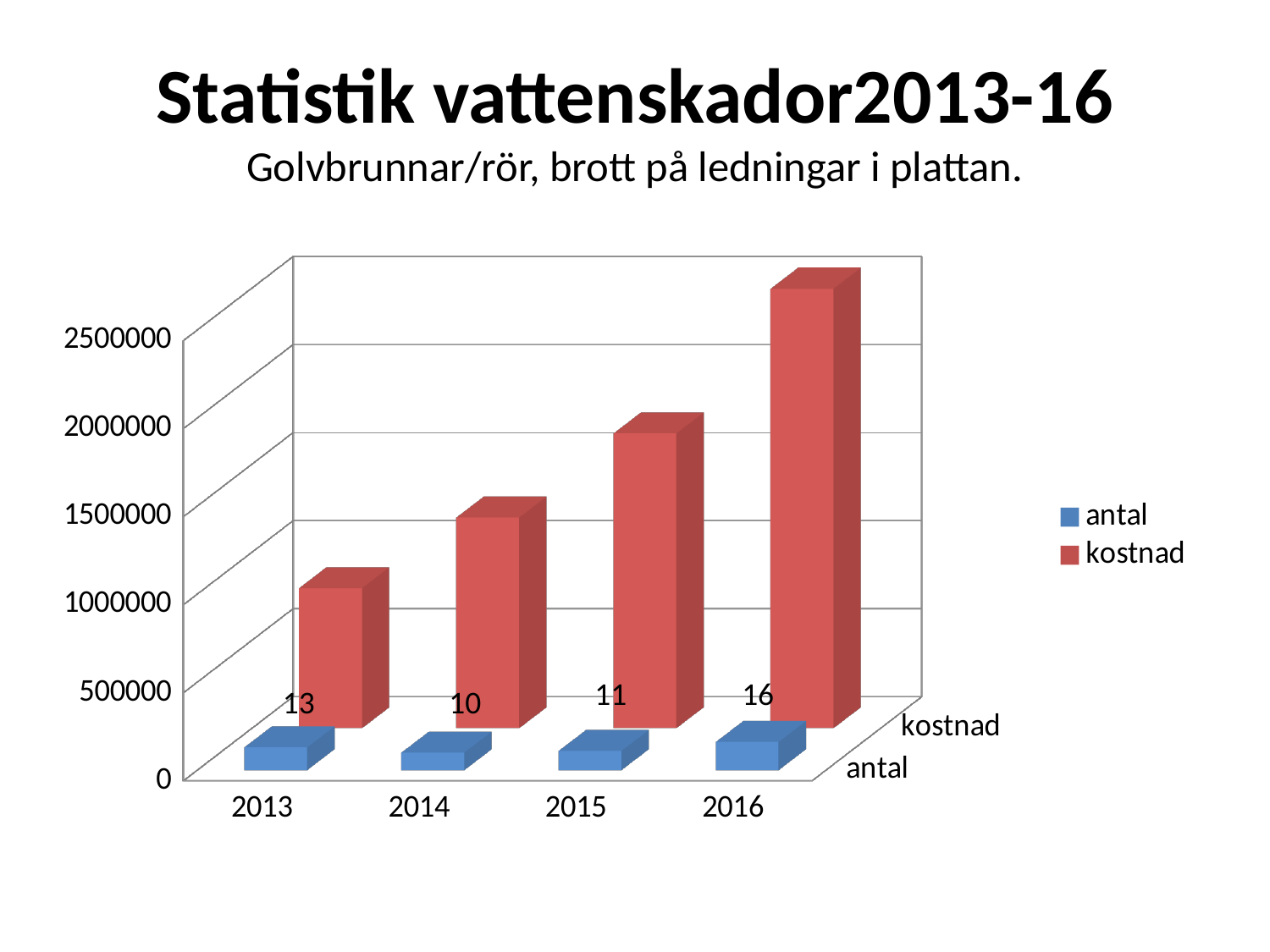
What is the antal value for 2016? 16 What is the difference between the antal values for 2016 and 2014? 6 How many series does the legend list? 2 Which is larger, the antal value for 2013 or for 2015? 2013 What is the antal value for 2014? 10 Which year has the highest kostnad value? 2016 What is the antal value for 2013? 13 Which year has the highest antal value? 2016 Does the kostnad series rise or fall from 2013 to 2016? rise Is the kostnad value for 2013 greater or less than 1500000? less Is the kostnad value for 2016 greater or less than 2000000? greater Which year has the lowest antal value? 2014